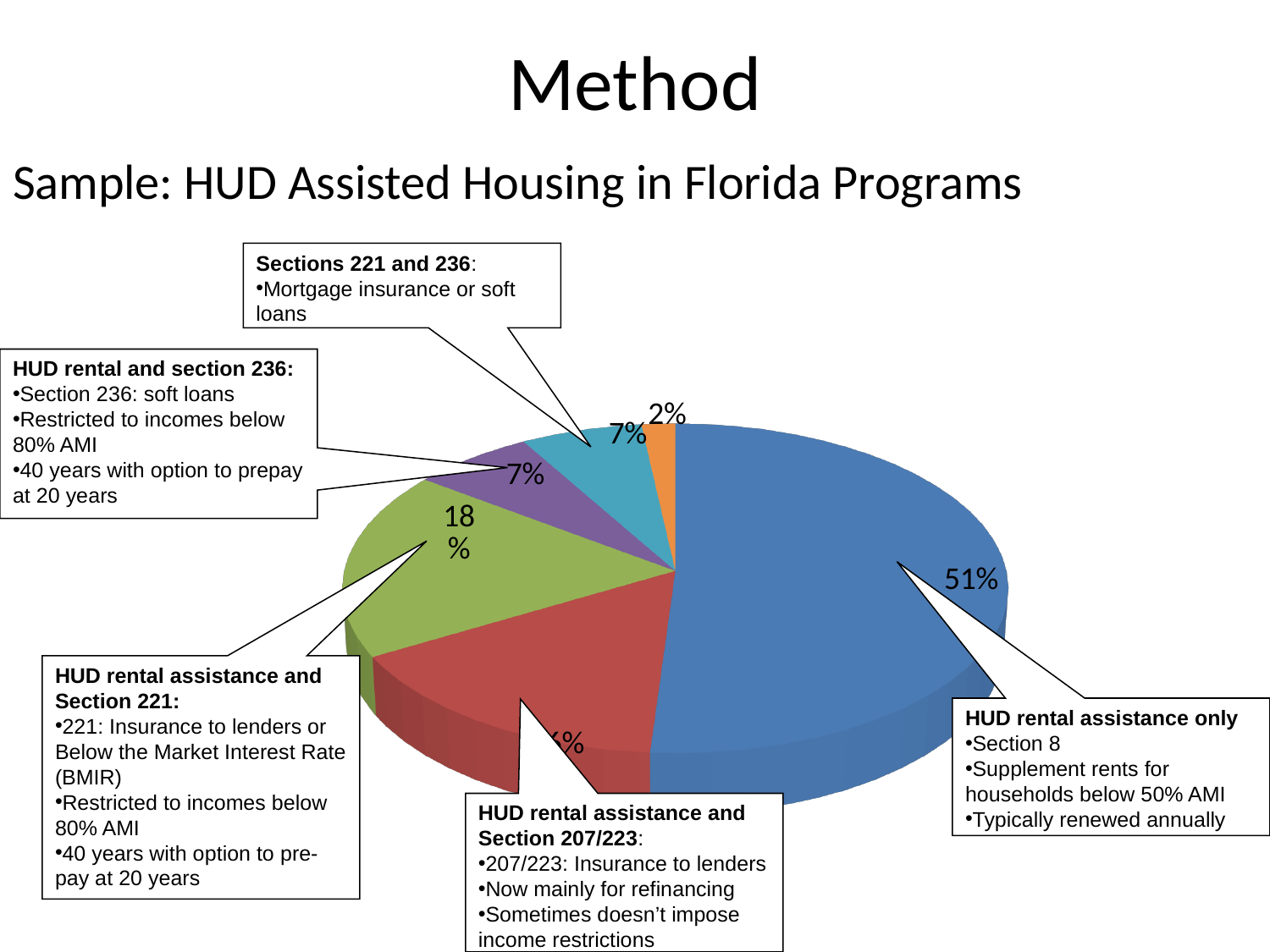
What kind of chart is shown on the slide? Pie chart What is the percentage shown on the smallest slice of the pie? 2% Which program category has the largest slice of the pie? HUD rental assistance only What colour is the largest slice of the pie? Blue What share of the pie is labelled for HUD rental assistance only? 51% What share of the pie is labelled for HUD rental and section 236? 7% Which is larger: the slice for HUD rental assistance only or the slice for HUD rental assistance and Section 221? HUD rental assistance only How many percentage points larger is the HUD rental assistance only slice than the HUD rental assistance and Section 221 slice? 33 percentage points Is the share for HUD rental assistance only greater or less than 50%? greater How many slices does the pie chart have? 6 What share of the pie is labelled for HUD rental assistance and Section 221? 18% What is the title of the slide? Method